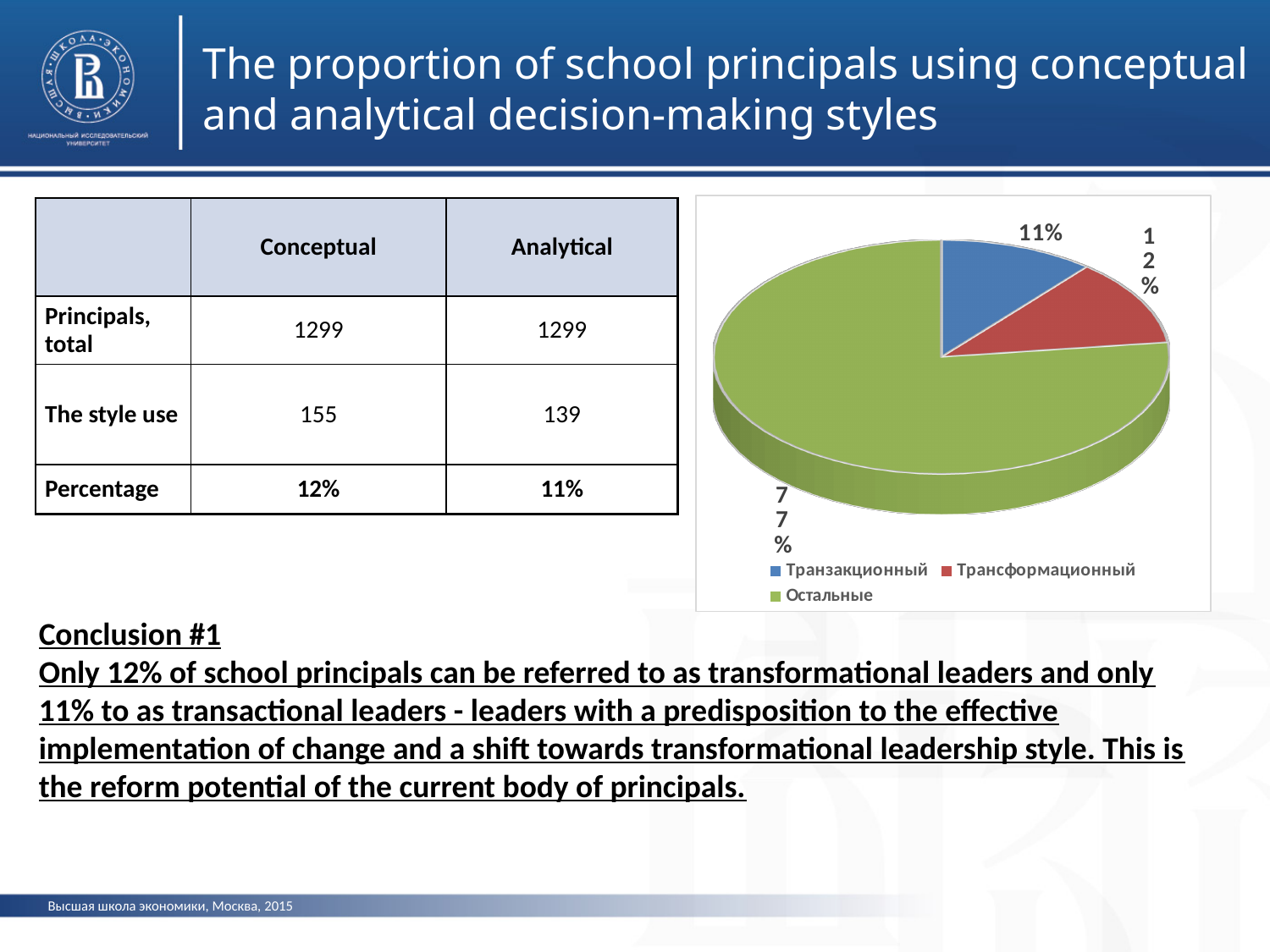
Which slice of the pie chart is the smallest? Транзакционный What percentage does the Трансформационный slice of the pie chart show? 12% What colour is the Остальные slice in the pie chart? green What percentage does the Транзакционный slice of the pie chart show? 11% How many slices does the pie chart have? 3 Which slice of the pie chart is the largest? Остальные What is the difference in percentage points between the Остальные slice and the Трансформационный slice? 65 How many entries does the pie chart's legend list? 3 What colour is the Транзакционный slice in the pie chart? blue What kind of chart is shown on the slide? pie chart Which is larger in the pie chart, the Транзакционный slice or the Трансформационный slice? Трансформационный What percentage does the Остальные slice of the pie chart show? 77%